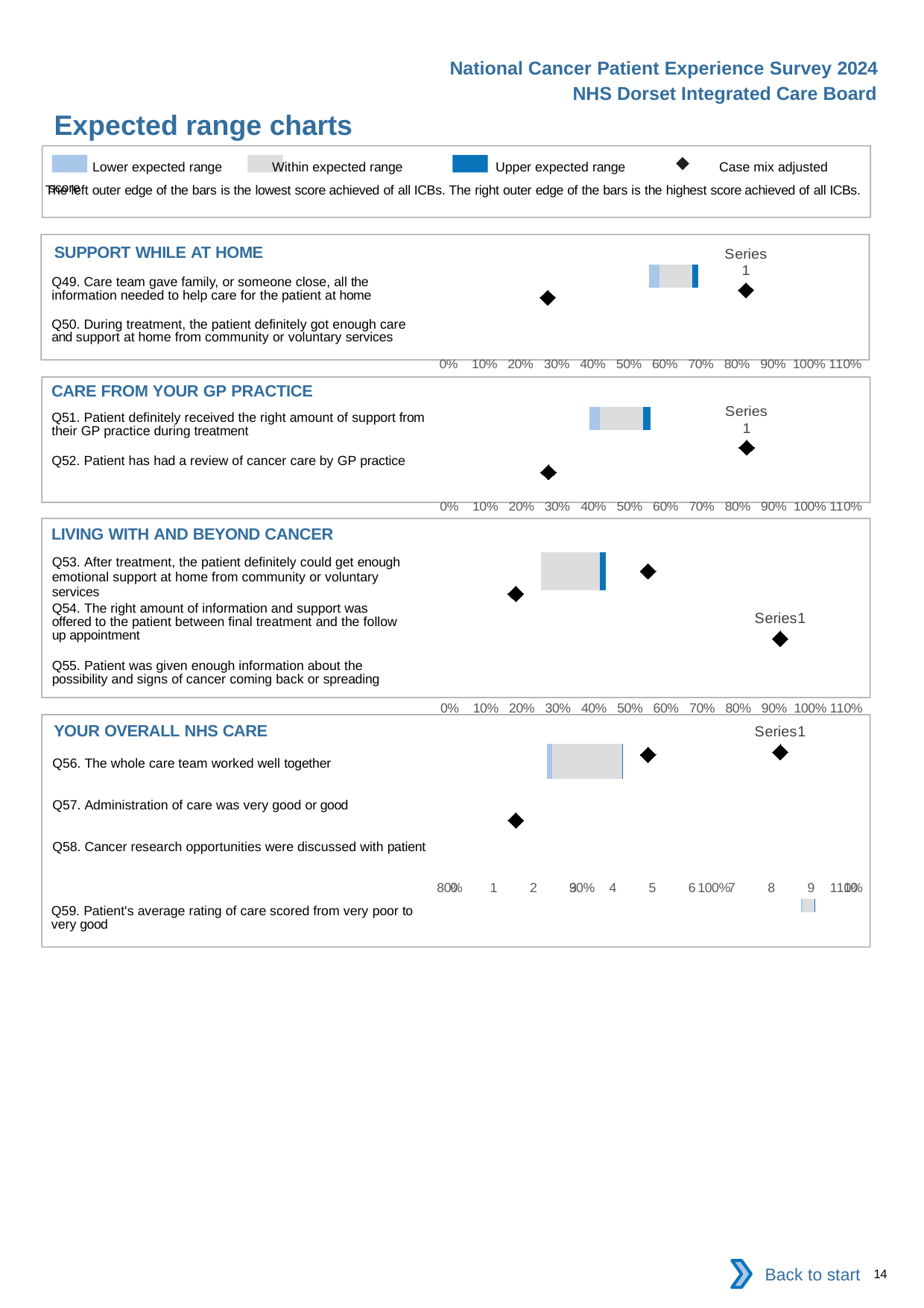
How many questions are listed in the CARE FROM YOUR GP PRACTICE chart? 2 What is the highest percentage tick shown on the x axis of the SUPPORT WHILE AT HOME chart? 110% What kind of chart is used in each section of the slide? Bar chart What is the title of the slide containing the charts? Expected range charts How many questions are listed in the LIVING WITH AND BEYOND CANCER chart? 3 How many questions are listed in the SUPPORT WHILE AT HOME chart? 2 How many entries does the legend at the top of the slide list? 4 In the CARE FROM YOUR GP PRACTICE chart, is the left edge of the expected range bar greater or less than 30%? greater In the legend, which colour represents the upper expected range? Dark blue In the LIVING WITH AND BEYOND CANCER chart, is the right edge of the expected range bar greater or less than 50%? less In the SUPPORT WHILE AT HOME chart, is the right edge of the expected range bar greater or less than 60%? greater